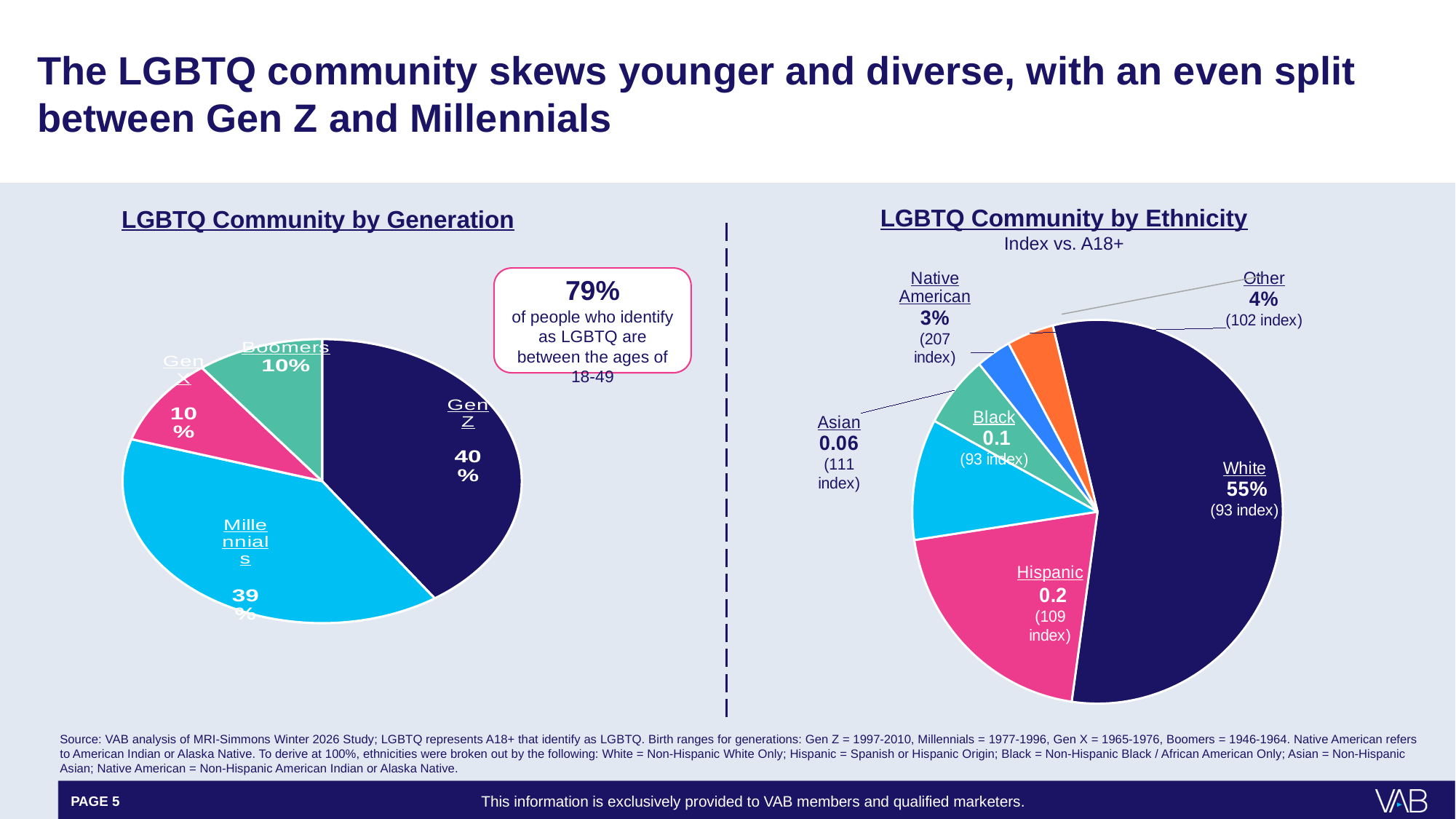
In the LGBTQ Community by Generation chart, what share is Gen Z? 40% In the LGBTQ Community by Generation chart, which generation has the largest share? Gen Z In the LGBTQ Community by Generation chart, how many generations are shown? 4 In the LGBTQ Community by Ethnicity chart, what share is White? 55% In the LGBTQ Community by Ethnicity chart, what index is shown for Native American? 207 index What kind of chart is the LGBTQ Community by Generation chart? Pie chart In the LGBTQ Community by Ethnicity chart, which ethnicity has the largest share? White In the LGBTQ Community by Ethnicity chart, how many ethnicity slices are shown? 6 In the LGBTQ Community by Generation chart, what share is Millennials? 39% In the LGBTQ Community by Generation chart, what share is Boomers? 10% In the LGBTQ Community by Ethnicity chart, what is the difference between the Other share and the Native American share? 1% In the LGBTQ Community by Ethnicity chart, what value is shown for Hispanic? 0.2